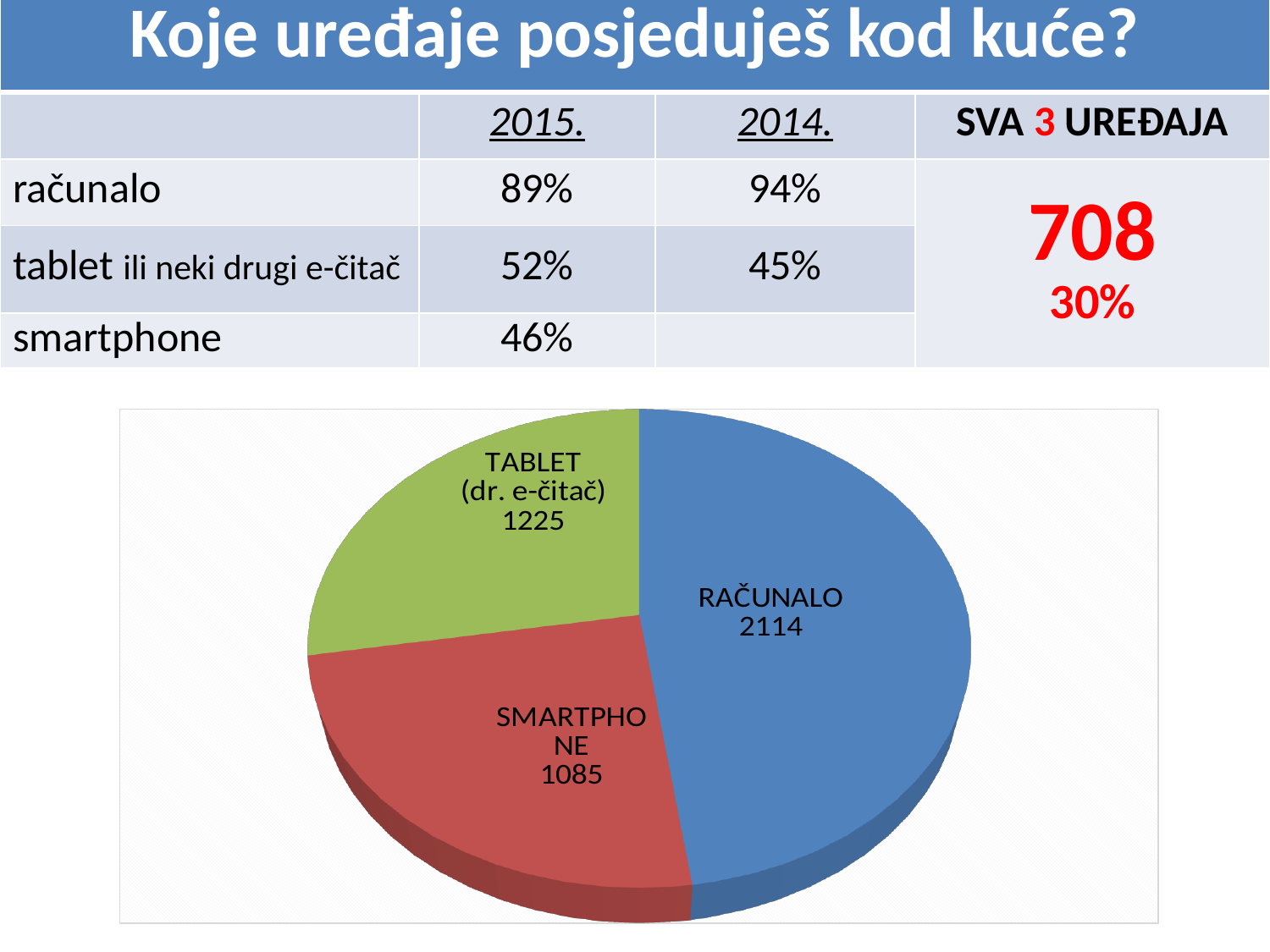
What kind of chart is shown on the slide? pie chart What is the value for SMARTPHONE in the pie chart? 1085 Which slice of the pie chart is the smallest? SMARTPHONE What is the value for RAČUNALO in the pie chart? 2114 How many slices does the pie chart have? 3 What is the total of all three slices in the pie chart? 4424 Which is larger in the pie chart, TABLET (dr. e-čitač) or SMARTPHONE? TABLET (dr. e-čitač) What colour is the RAČUNALO slice in the pie chart? blue Which slice of the pie chart is the largest? RAČUNALO What is the difference between the RAČUNALO and SMARTPHONE values in the pie chart? 1029 What is the value for TABLET (dr. e-čitač) in the pie chart? 1225 What is the difference between the TABLET (dr. e-čitač) and SMARTPHONE values in the pie chart? 140